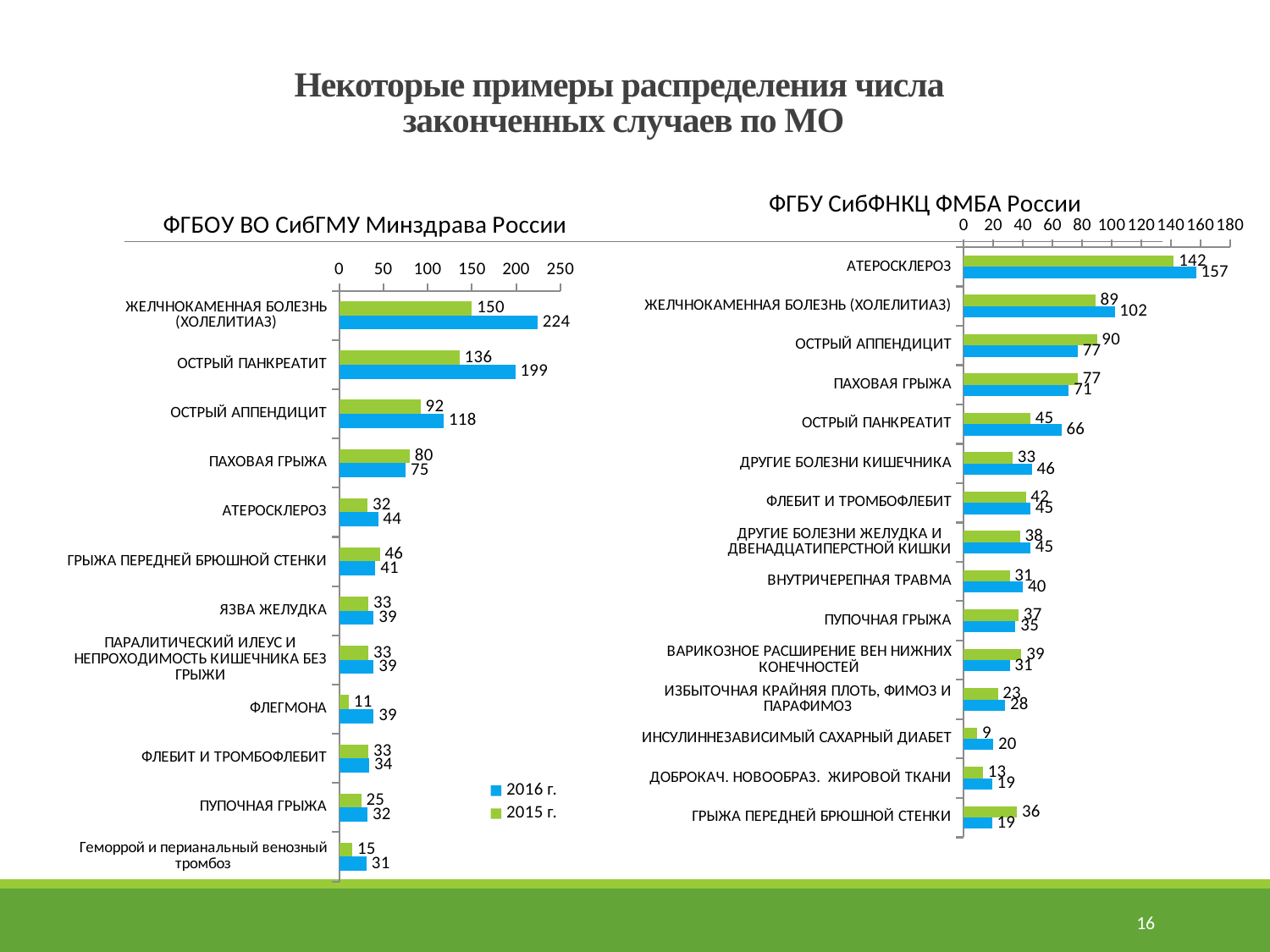
In the chart titled 'ФГБОУ ВО СибГМУ Минздрава России', what is the difference between the 2016 г. and 2015 г. values for ОСТРЫЙ ПАНКРЕАТИТ? 63 In the chart titled 'ФГБОУ ВО СибГМУ Минздрава России', how many series does the legend list? 2 In the chart titled 'ФГБОУ ВО СибГМУ Минздрава России', how many categories are shown? 12 In the chart titled 'ФГБУ СибФНКЦ ФМБА России', which category has the lowest 2015 г. value? ИНСУЛИННЕЗАВИСИМЫЙ САХАРНЫЙ ДИАБЕТ In the chart titled 'ФГБУ СибФНКЦ ФМБА России', what is the 2016 г. value for АТЕРОСКЛЕРОЗ? 157 In the chart titled 'ФГБОУ ВО СибГМУ Минздрава России', what is the 2015 г. value for ФЛЕГМОНА? 11 In the chart titled 'ФГБУ СибФНКЦ ФМБА России', how many categories are shown? 15 In the chart titled 'ФГБУ СибФНКЦ ФМБА России', which is larger for ОСТРЫЙ АППЕНДИЦИТ: the 2015 г. value or the 2016 г. value? 2015 г. In the chart titled 'ФГБУ СибФНКЦ ФМБА России', what is the 2015 г. value for ИНСУЛИННЕЗАВИСИМЫЙ САХАРНЫЙ ДИАБЕТ? 9 What type of chart is the chart titled 'ФГБУ СибФНКЦ ФМБА России'? Bar chart In the chart titled 'ФГБОУ ВО СибГМУ Минздрава России', what is the 2016 г. value for ЖЕЛЧНОКАМЕННАЯ БОЛЕЗНЬ (ХОЛЕЛИТИАЗ)? 224 In the chart titled 'ФГБОУ ВО СибГМУ Минздрава России', which category has the highest 2016 г. value? ЖЕЛЧНОКАМЕННАЯ БОЛЕЗНЬ (ХОЛЕЛИТИАЗ)